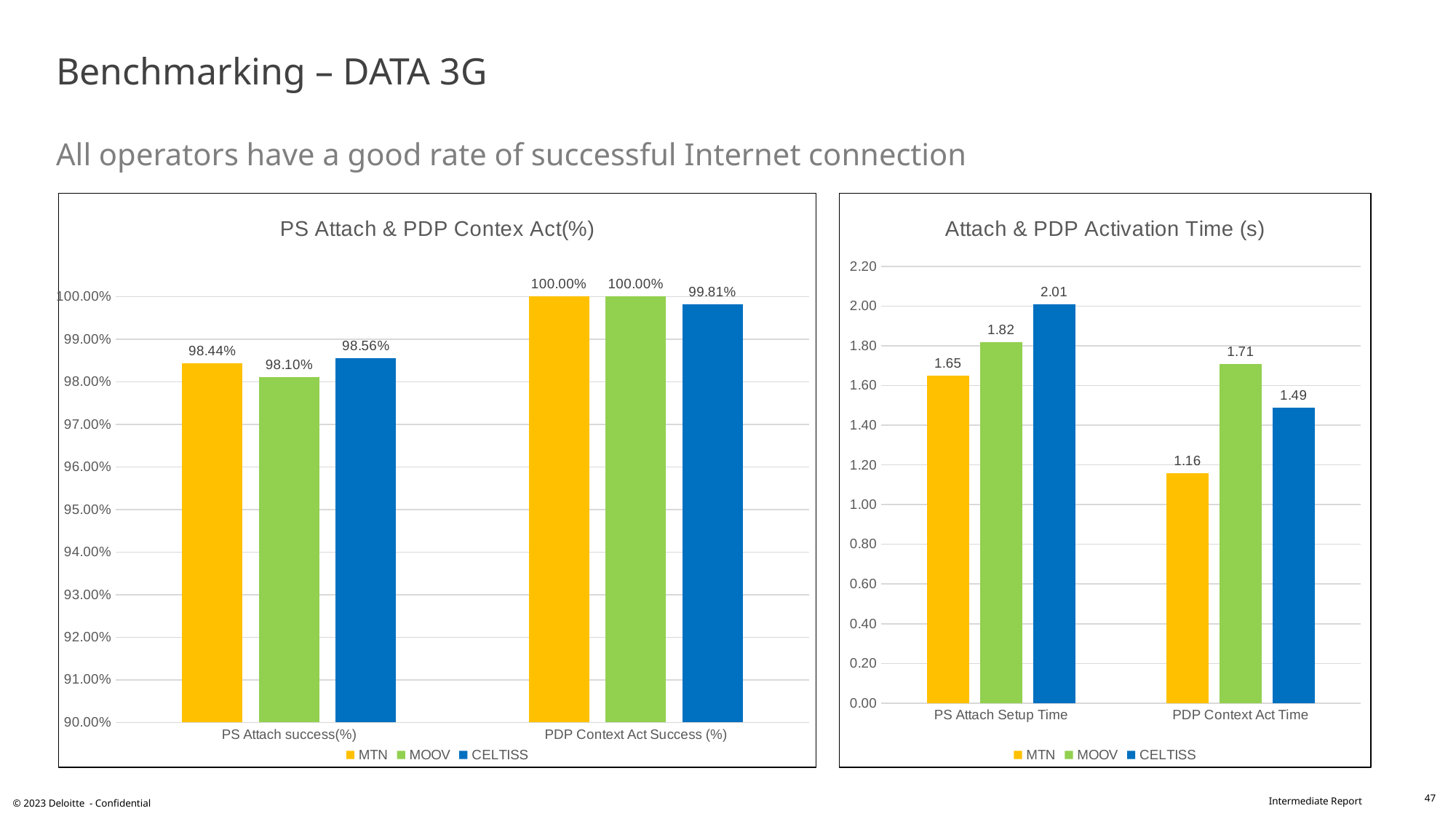
What kind of chart is the 'Attach & PDP Activation Time (s)' chart? Bar chart In the 'PS Attach & PDP Contex Act(%)' chart, which operator has the highest PS Attach success(%)? CELTISS In the 'PS Attach & PDP Contex Act(%)' chart, how many series does the legend list? 3 In the 'Attach & PDP Activation Time (s)' chart, which is larger: the PDP Context Act Time for MOOV or for CELTISS? MOOV In the 'Attach & PDP Activation Time (s)' chart, what is the PDP Context Act Time for MTN? 1.16 In the 'PS Attach & PDP Contex Act(%)' chart, what is the difference between the PS Attach success(%) values of CELTISS and MOOV? 0.46% In the 'PS Attach & PDP Contex Act(%)' chart, what is the PDP Context Act Success (%) value for CELTISS? 99.81% In the 'PS Attach & PDP Contex Act(%)' chart, what is the PS Attach success(%) value for MOOV? 98.10% In the 'Attach & PDP Activation Time (s)' chart, what is the difference between the PS Attach Setup Time of CELTISS and MTN? 0.36 In the 'Attach & PDP Activation Time (s)' chart, how many categories are shown on the x axis? 2 In the 'Attach & PDP Activation Time (s)' chart, which operator has the lowest PDP Context Act Time? MTN In the 'Attach & PDP Activation Time (s)' chart, what is the PS Attach Setup Time for CELTISS? 2.01